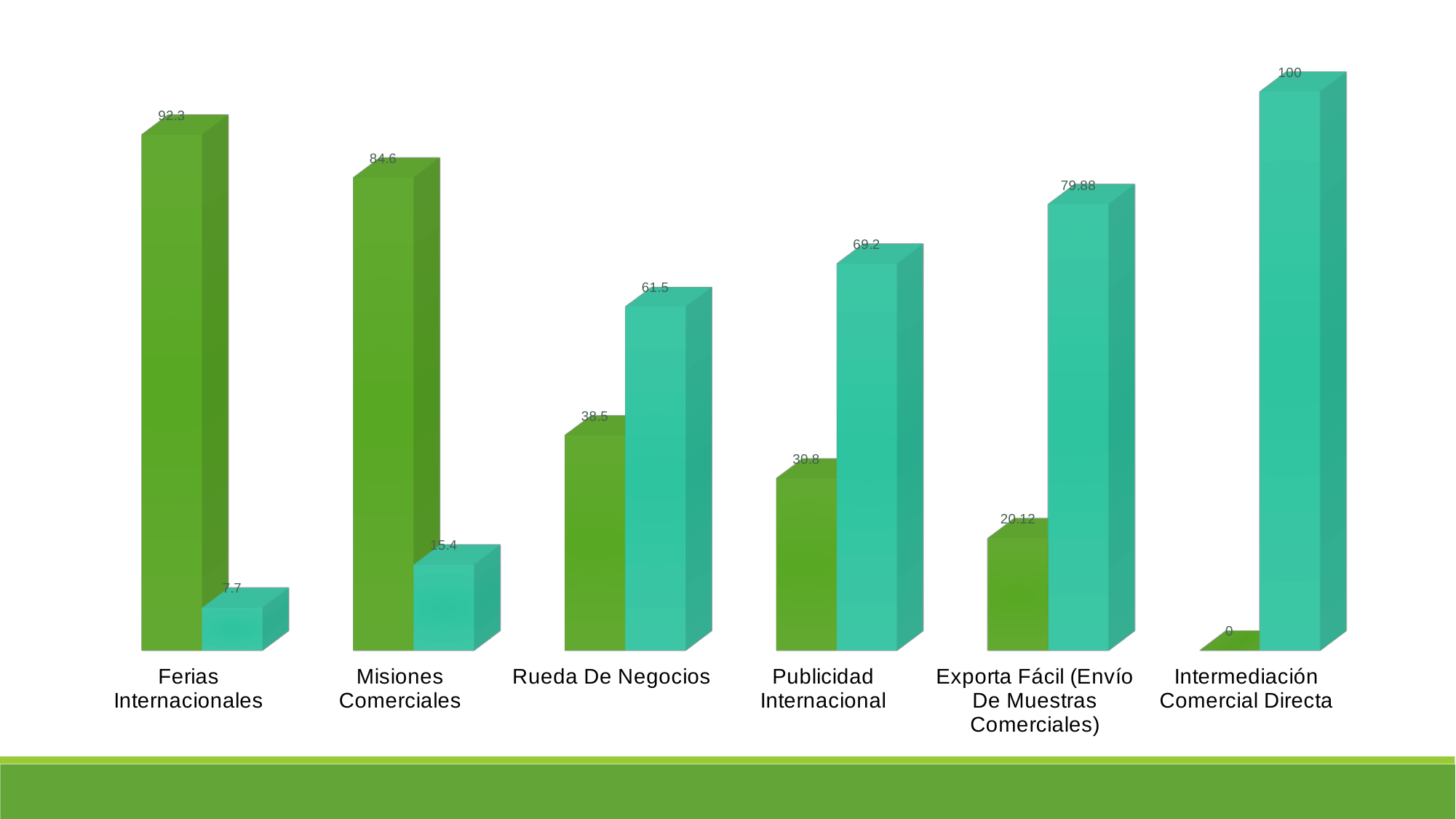
Which category has the lowest green bar? Intermediación Comercial Directa What is the value of the green bar for Publicidad Internacional? 30.8 How many categories are shown on the x axis? 6 What kind of chart is shown on the slide? bar chart What is the value of the green bar for Ferias Internacionales? 92.3 For Publicidad Internacional, which is larger, the green bar or the teal bar? the teal bar What is the difference between the green bars for Ferias Internacionales and Misiones Comerciales? 7.7 What is the difference between the teal and green bars for Rueda De Negocios? 23 What is the value of the teal bar for Exporta Fácil (Envío De Muestras Comerciales)? 79.88 Do the green bars rise or fall from left to right across the categories? fall What is the value of the teal bar for Misiones Comerciales? 15.4 Which category has the highest teal bar? Intermediación Comercial Directa